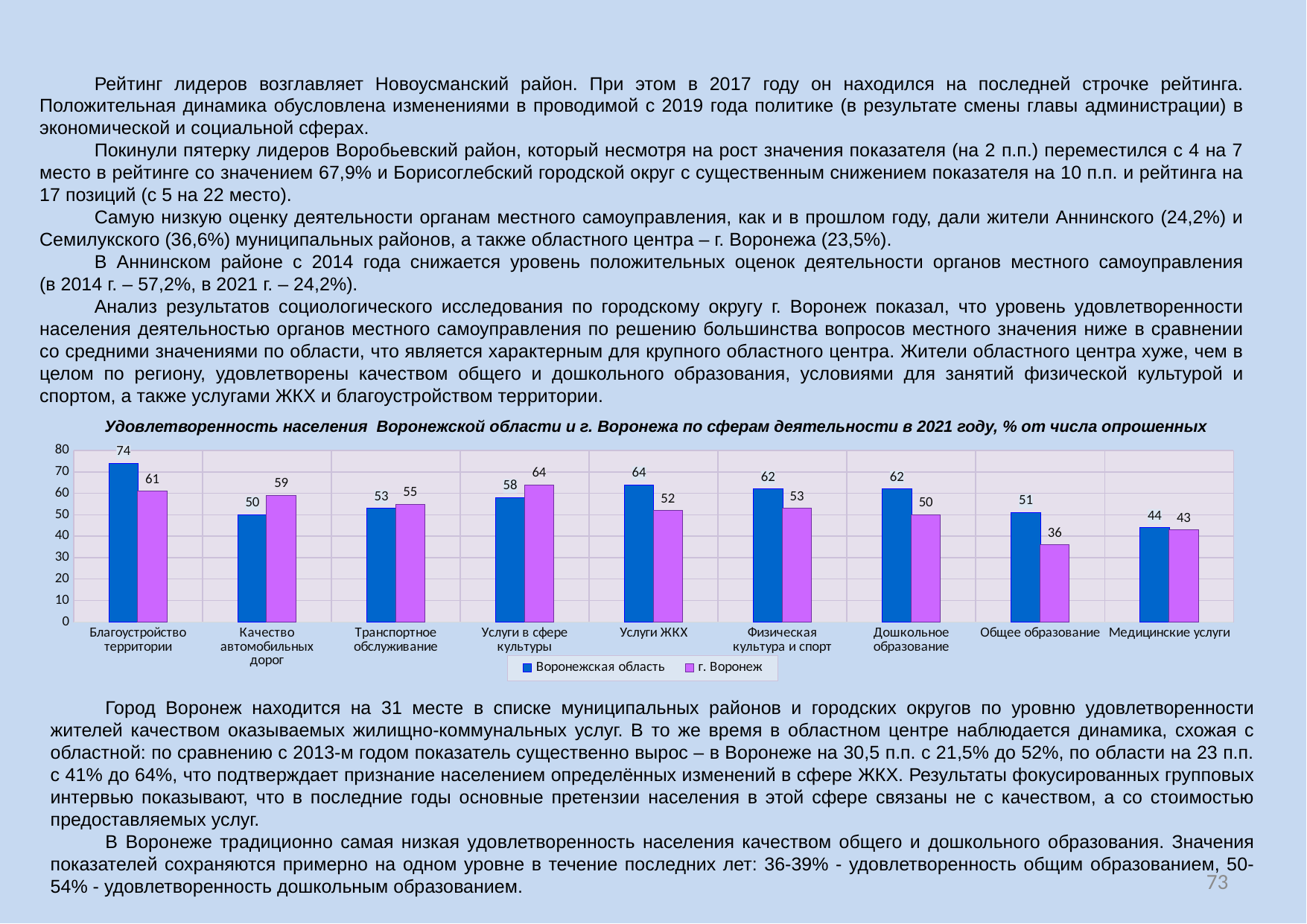
How many series does the chart legend list? 2 What is the difference between Воронежская область and г. Воронеж in the category Общее образование? 15 Which category has the highest value for the series Воронежская область? Благоустройство территории What type of chart is shown on the slide? Bar chart In the category Качество автомобильных дорог, which series has the larger value: Воронежская область or г. Воронеж? г. Воронеж What is the value for Воронежская область in the category Благоустройство территории? 74 What is the value for г. Воронеж in the category Услуги ЖКХ? 52 Which category has the lowest value for the series Воронежская область? Медицинские услуги How many categories are shown on the x axis of the chart? 9 What is the value for г. Воронеж in the category Общее образование? 36 What is the title of the chart? Удовлетворенность населения Воронежской области и г. Воронежа по сферам деятельности в 2021 году, % от числа опрошенных Which category has the lowest value for the series г. Воронеж? Общее образование